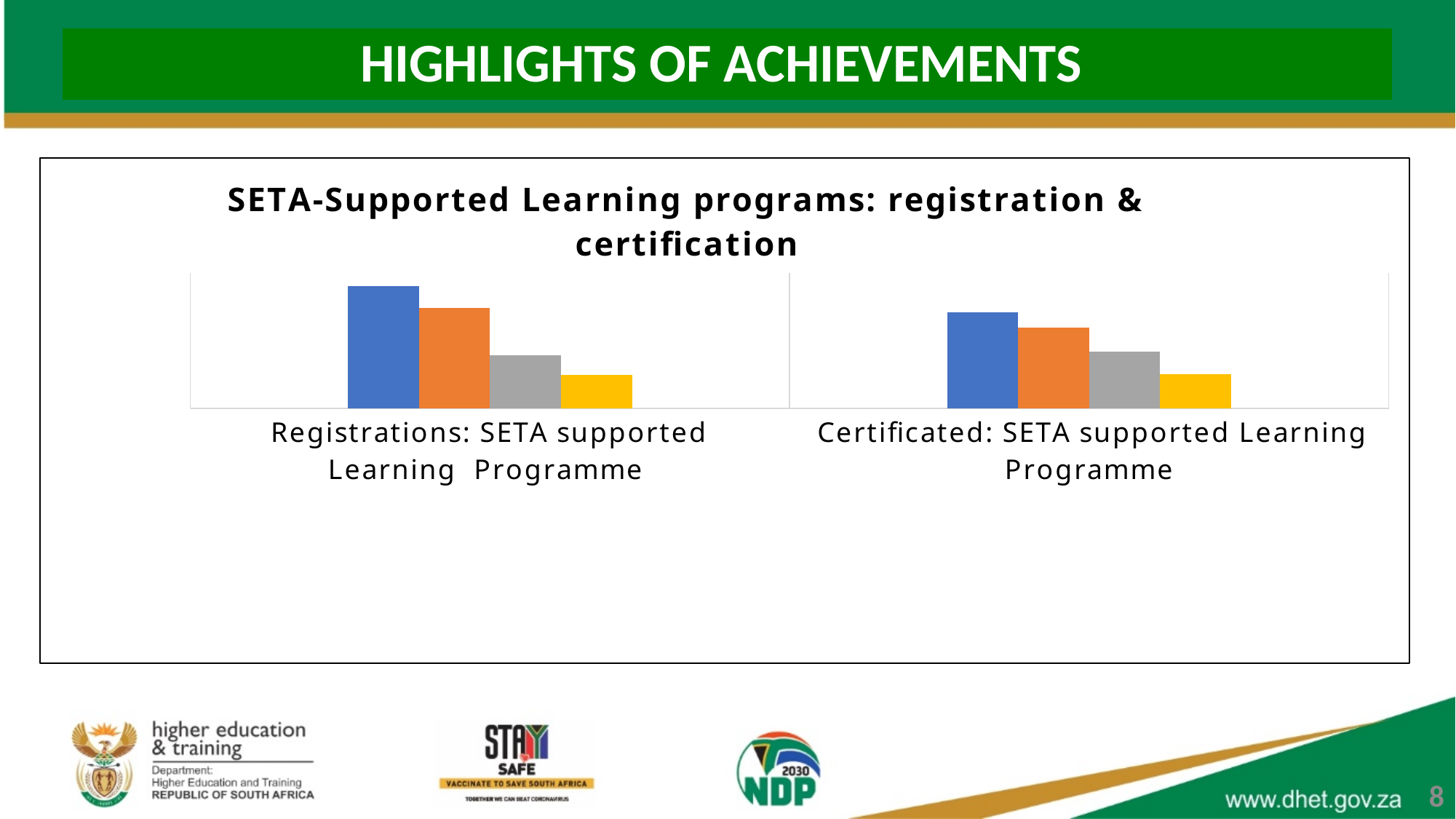
How many bars are plotted for the 'Registrations: SETA supported Learning Programme' category? 4 Which coloured bar is the shortest in the 'Certificated: SETA supported Learning Programme' category? yellow How many categories are shown on the x axis of the chart? 2 Which coloured bar is the tallest in the 'Certificated: SETA supported Learning Programme' category? blue Does the chart display a legend? No Within the 'Registrations: SETA supported Learning Programme' category, do the bars rise or fall from left to right? fall What kind of chart is shown on the slide? bar chart What is the title of the chart? SETA-Supported Learning programs: registration & certification Is the blue bar taller for 'Registrations: SETA supported Learning Programme' or for 'Certificated: SETA supported Learning Programme'? Registrations: SETA supported Learning Programme How many bars are plotted for the 'Certificated: SETA supported Learning Programme' category? 4 Which coloured bar is the shortest in the 'Registrations: SETA supported Learning Programme' category? yellow Which coloured bar is the tallest in the 'Registrations: SETA supported Learning Programme' category? blue